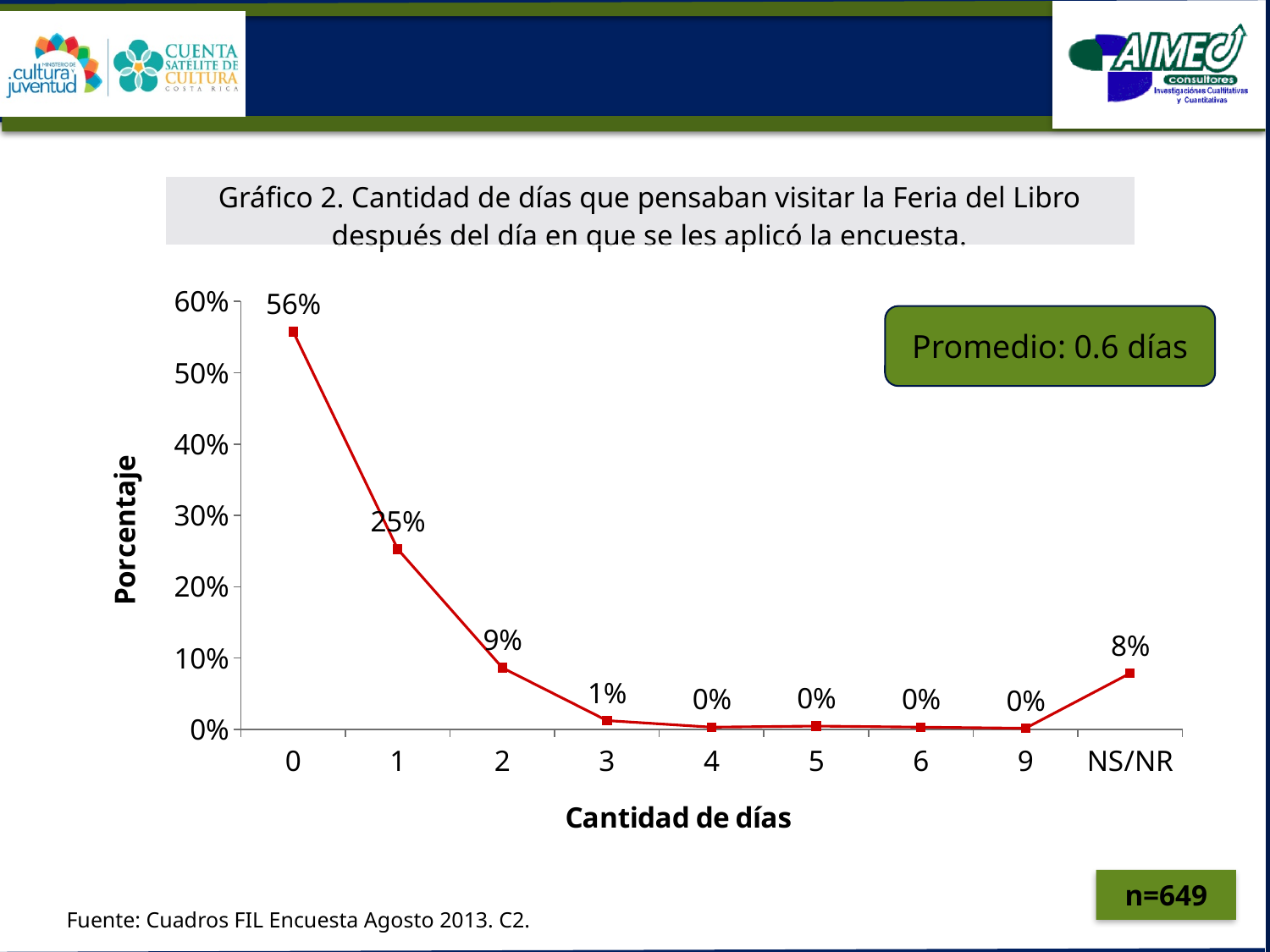
What kind of chart is shown on the slide? line chart What percentage of respondents planned to visit the Feria del Libro for 0 more days? 56% What is the value for the NS/NR category? 8% What is the label of the y axis? Porcentaje What is the value for 2 days? 9% How many categories are shown on the x axis? 9 Is the value for 1 day greater or less than 20%? greater Do the values rise or fall from 0 days to 3 days? fall What is the difference between the values for 0 days and 1 day? 31% What is the value for 1 day in the chart? 25% Which is larger, the value for 2 days or the value for NS/NR? 2 days Which category has the highest value? 0